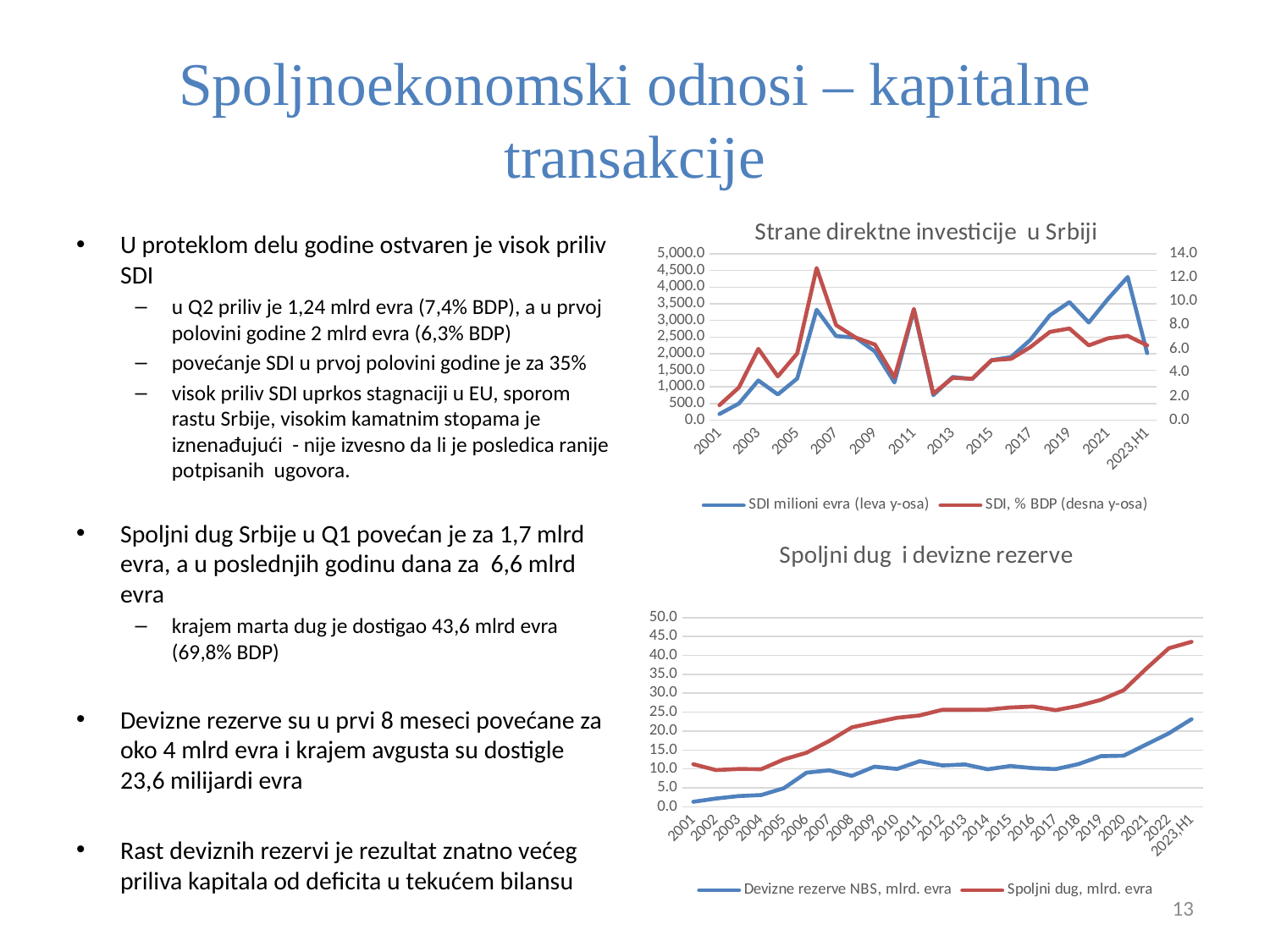
In the 'Spoljni dug i devizne rezerve' chart, does the 'Spoljni dug, mlrd. evra' series generally rise or fall from 2001 to 2023,H1? rise What kind of chart is the 'Spoljni dug i devizne rezerve' chart? line chart In the 'Strane direktne investicije u Srbiji' chart, in which year does the 'SDI milioni evra' series reach its highest value? 2022 In the 'Strane direktne investicije u Srbiji' chart, which series is plotted on the right y-axis according to the legend? SDI, % BDP (desna y-osa) In the 'Strane direktne investicije u Srbiji' chart, is the 'SDI milioni evra' value for 2022 greater or less than 4,000.0? greater In the 'Strane direktne investicije u Srbiji' chart, is the 'SDI, % BDP' value for 2006 greater or less than 10.0? greater In the 'Spoljni dug i devizne rezerve' chart, is the 'Spoljni dug, mlrd. evra' value for 2023,H1 greater or less than 40.0? greater How many series does the legend of the 'Strane direktne investicije u Srbiji' chart list? 2 In the 'Spoljni dug i devizne rezerve' chart, which series has the larger value in 2023,H1: 'Devizne rezerve NBS, mlrd. evra' or 'Spoljni dug, mlrd. evra'? Spoljni dug, mlrd. evra What kind of chart is the 'Strane direktne investicije u Srbiji' chart? line chart How many x-axis categories (years) does the 'Spoljni dug i devizne rezerve' chart show? 23 In the 'Strane direktne investicije u Srbiji' chart, in which year does the 'SDI, % BDP' series reach its highest value? 2006